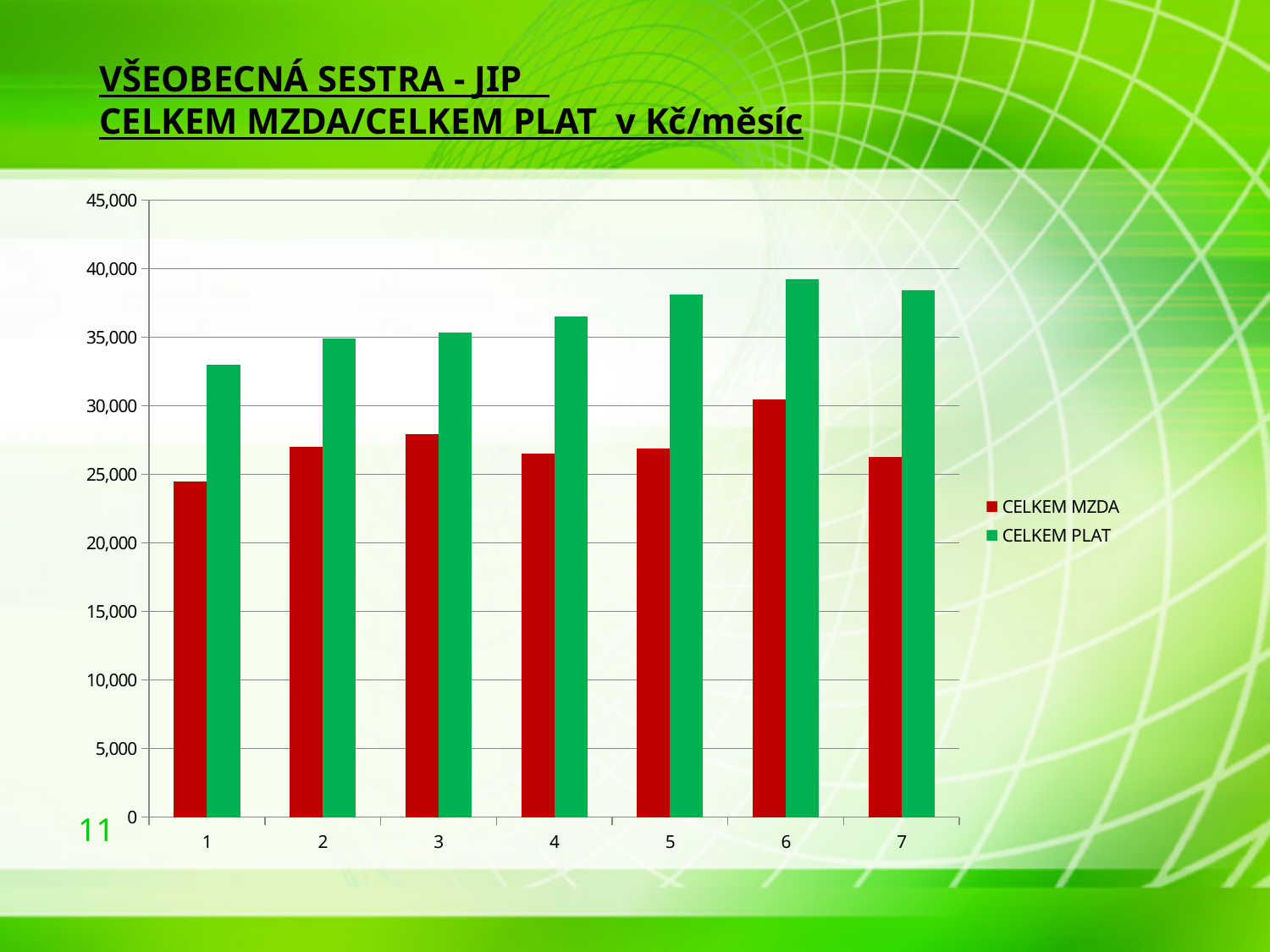
How many categories are shown on the x axis? 7 Is the CELKEM PLAT value for category 1 greater or less than 30,000? greater Does the CELKEM PLAT series generally rise or fall from category 1 to category 6? rise What kind of chart is shown on the slide? bar chart Which category has the lowest CELKEM MZDA value? 1 Is the CELKEM PLAT value for category 6 greater or less than 40,000? less How many series does the legend list? 2 Is the CELKEM MZDA value for category 1 greater or less than 25,000? less In category 1, which is larger: CELKEM MZDA or CELKEM PLAT? CELKEM PLAT Which colour represents CELKEM MZDA in the legend? red Which category has the lowest CELKEM PLAT value? 1 Which category has the highest CELKEM MZDA value? 6